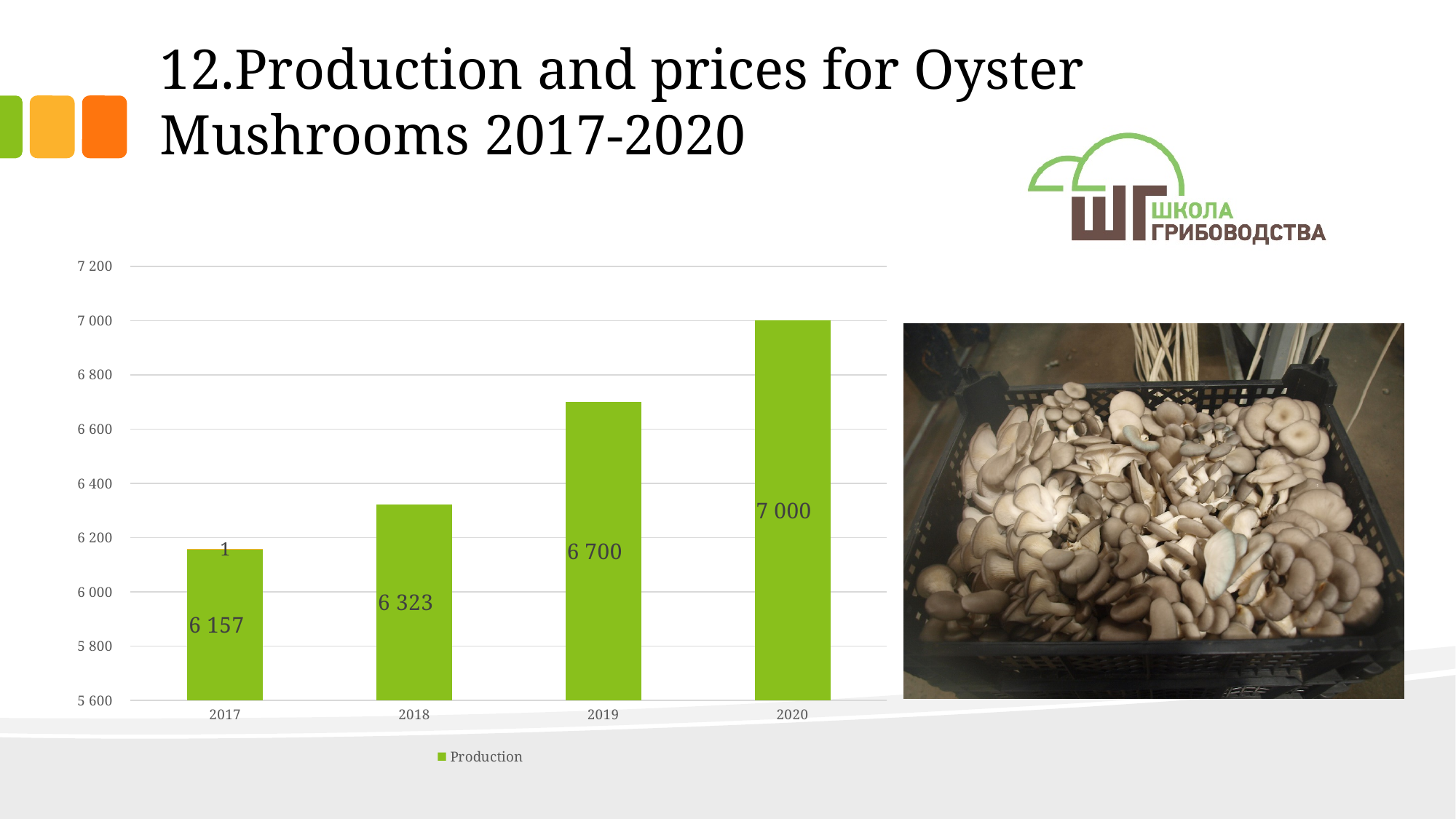
Which year has higher production, 2018 or 2019? 2019 What is the difference in production between 2019 and 2018? 377 Does production rise or fall from 2017 to 2020? rise Is the production value for 2018 greater or less than 6 400? less What is the difference in production between 2020 and 2017? 843 What is the production value for 2017? 6 157 Which year has the lowest production? 2017 What is the production value for 2018? 6 323 Which year has the highest production? 2020 What kind of chart is shown on the slide? bar chart What is the production value for 2019? 6 700 How many years are shown on the x axis of the chart? 4